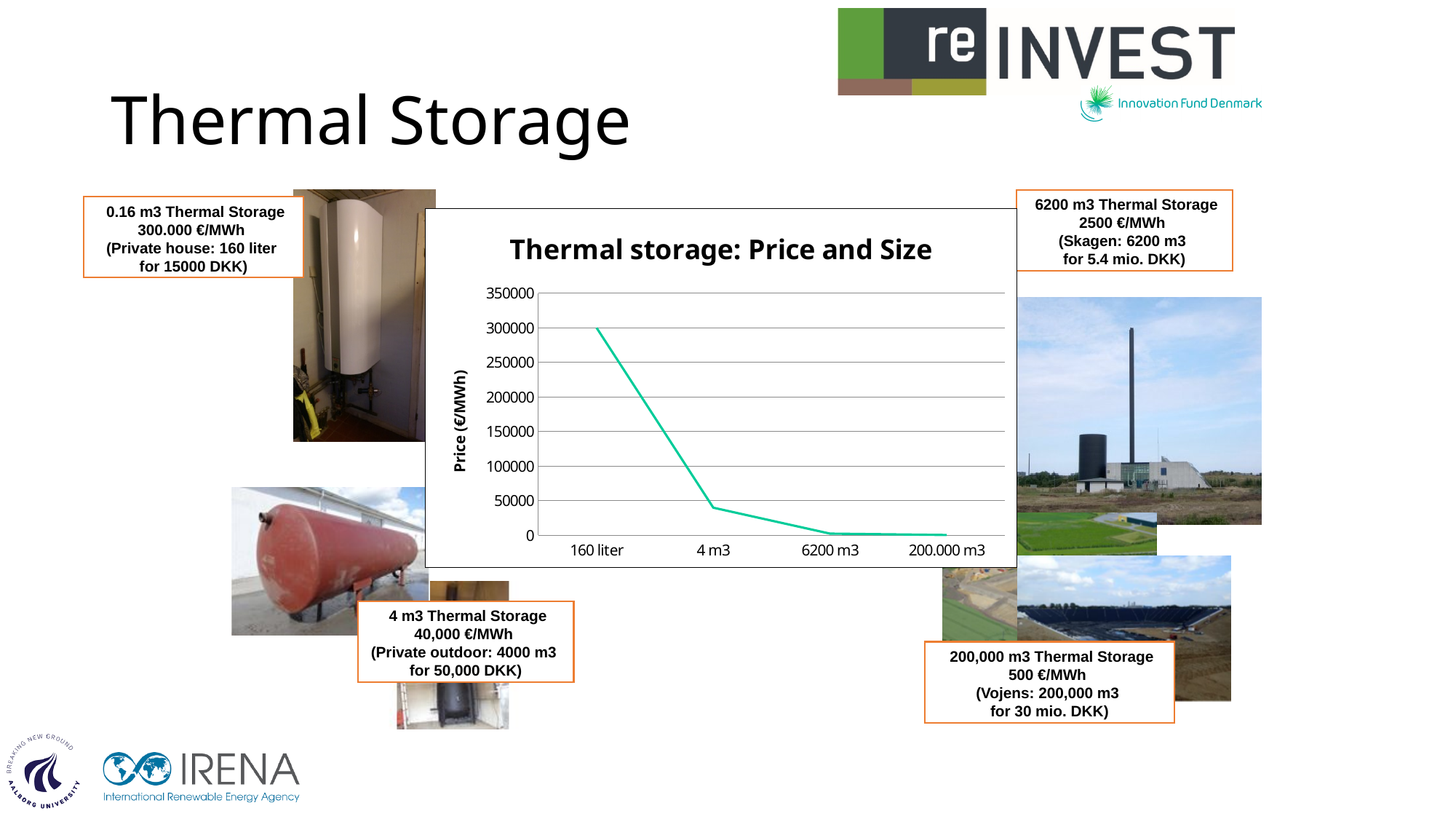
What is the title of the chart? Thermal storage: Price and Size Is the price for 160 liter greater or less than 250000 €/MWh? greater Is the price for 6200 m3 greater or less than 50000 €/MWh? less What is the label of the y axis? Price (€/MWh) Which has a higher price per MWh, 160 liter or 4 m3? 160 liter Which storage size has the highest price per MWh in the chart? 160 liter What type of chart is shown on the slide? line chart Is the price for 200,000 m3 greater or less than 50000 €/MWh? less Do the prices rise or fall as storage size increases along the x axis? fall What is the price per MWh plotted for 160 liter? 300000 How many storage sizes are plotted on the x axis of the chart? 4